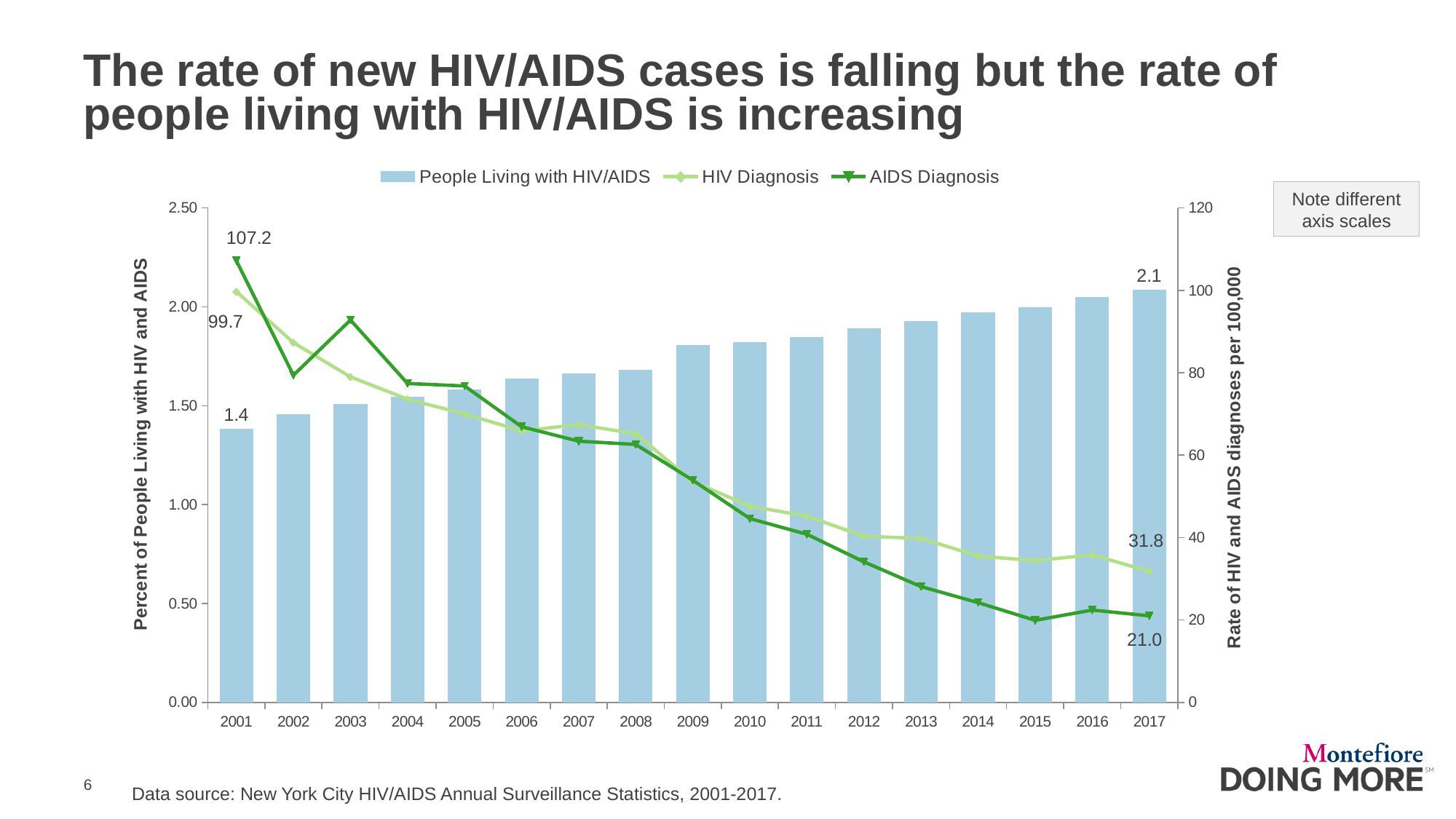
Do the People Living with HIV/AIDS bars rise or fall from 2001 to 2017? rise What is the value for People Living with HIV/AIDS in 2001? 1.4 In 2001, which was higher: the HIV Diagnosis rate or the AIDS Diagnosis rate? AIDS Diagnosis What is the HIV Diagnosis rate in 2017? 31.8 What is the value for People Living with HIV/AIDS in 2017? 2.1 What is the HIV Diagnosis rate in 2001? 99.7 What is the AIDS Diagnosis rate in 2017? 21.0 By how much did the AIDS Diagnosis rate fall from 2001 to 2017? 86.2 How many years are shown on the x axis? 17 How many series does the legend list? 3 Is the value for People Living with HIV/AIDS in 2010 greater or less than 1.50? greater What is the AIDS Diagnosis rate in 2001? 107.2